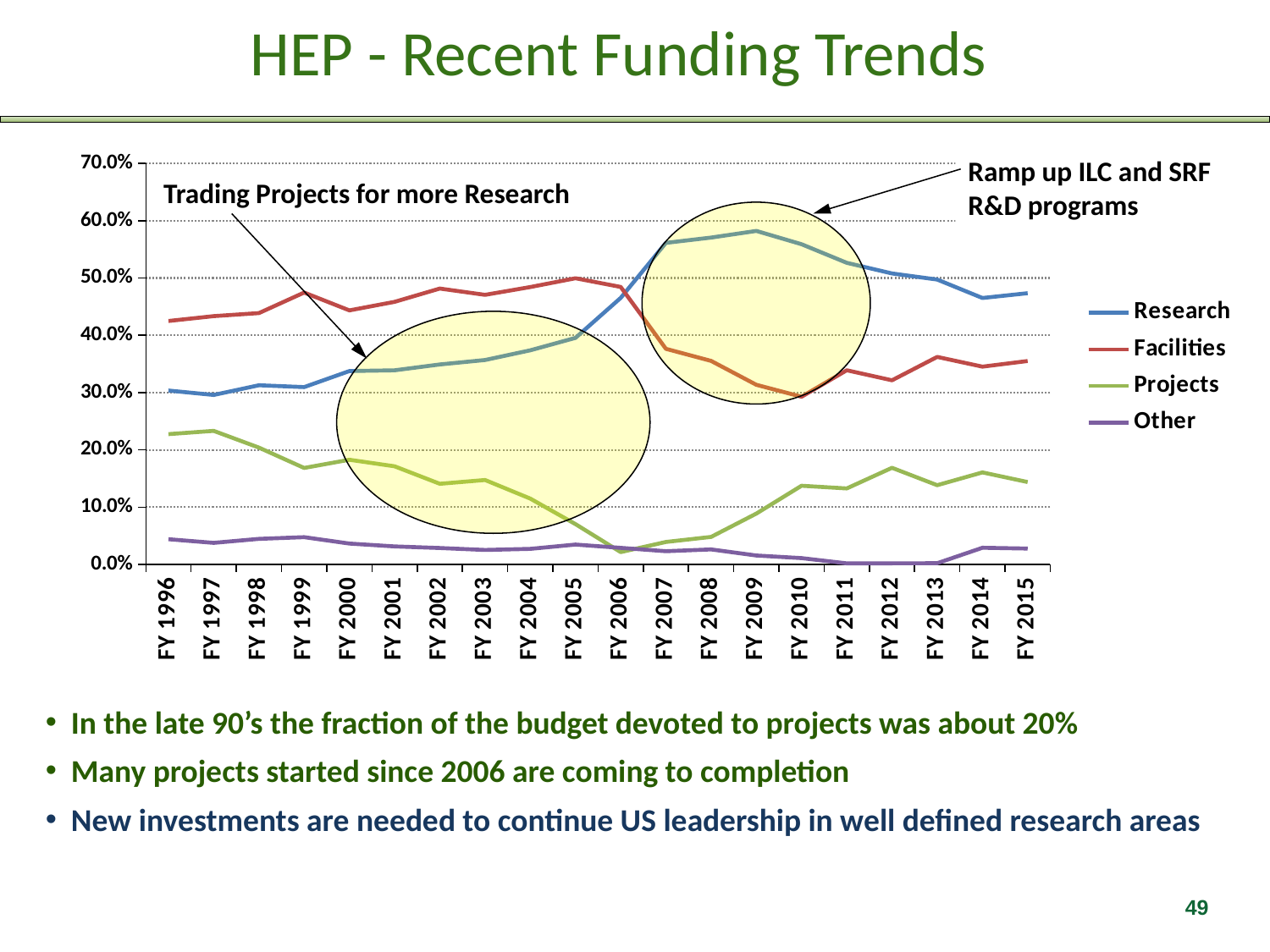
Is the value for Projects in FY 2006 greater or less than 10.0%? less Does the Projects series rise or fall from FY 1999 to FY 2006? Fall Is the value for Facilities in FY 1996 greater or less than 40.0%? greater In FY 2000, which is larger: Research or Facilities? Facilities What kind of chart is shown on the slide? Line chart How many series does the legend list? 4 Is the value for Research in FY 2009 greater or less than 50.0%? greater What colour is the line for Facilities? Red How many fiscal years are plotted along the x axis? 20 Which series has the highest value in FY 2009? Research